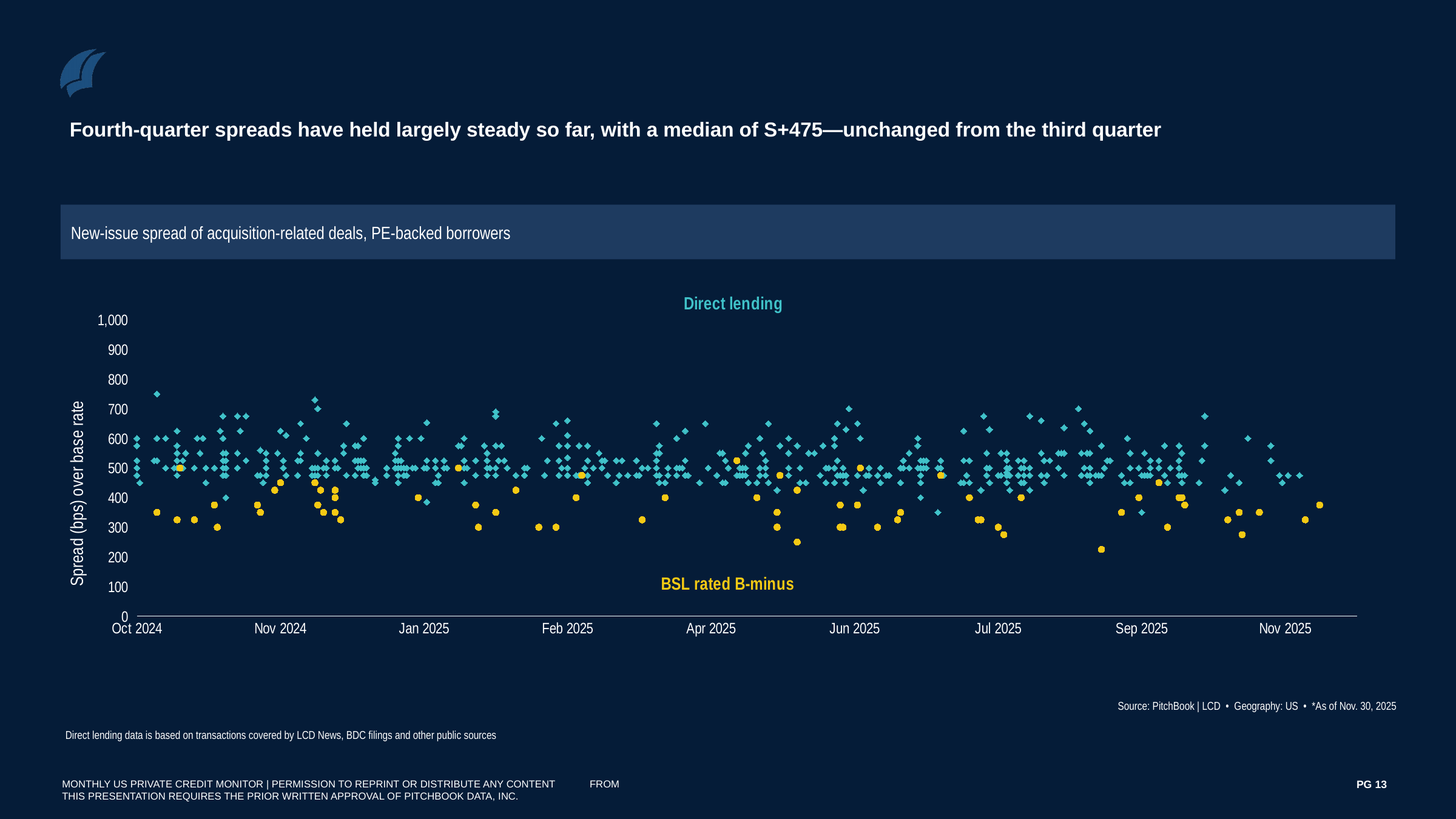
Which series contains the lowest plotted point on the chart? BSL rated B-minus Is the highest BSL rated B-minus point greater or less than 600? less What is the label of the vertical axis? Spread (bps) over base rate Is the lowest BSL rated B-minus point greater or less than 300? less Which series generally shows higher spreads, Direct lending or BSL rated B-minus? Direct lending Is the highest Direct lending point greater or less than 700? greater Which series contains the highest plotted point on the chart? Direct lending How many month labels are shown along the horizontal axis? 9 What is the highest value shown on the vertical axis? 1,000 How many data series are plotted on the chart? 2 What kind of chart is shown on the slide? Scatter chart What are the names of the two series plotted on the chart? Direct lending and BSL rated B-minus